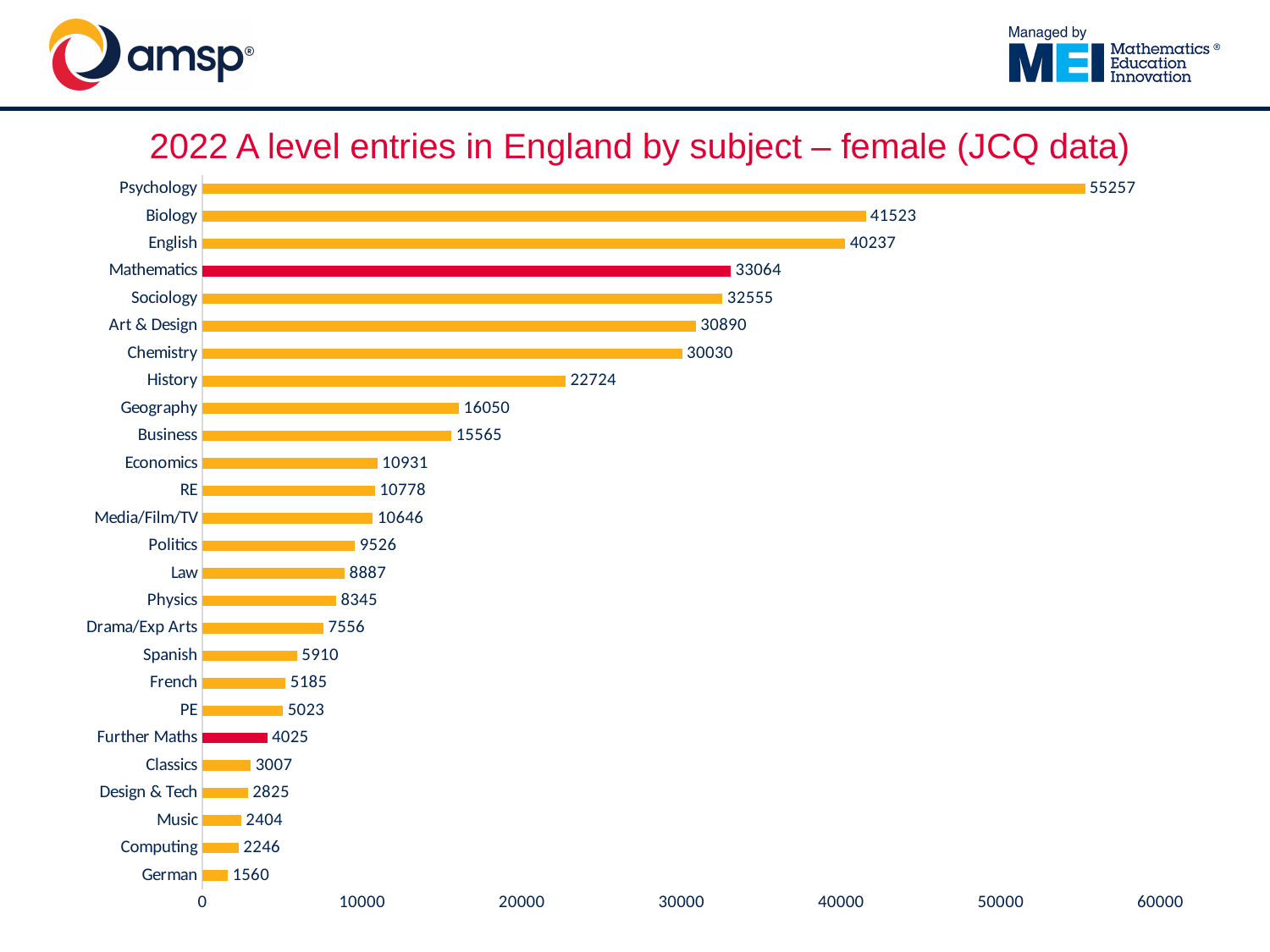
Which subject has the lowest number of female A level entries? German What is the number of female A level entries for Further Maths? 4025 What type of chart is shown on the slide? Bar chart Which subject has the highest number of female A level entries? Psychology Which two subjects are highlighted with red bars instead of orange? Mathematics and Further Maths What is the number of female A level entries for Chemistry? 30030 What is the difference between the female entries for Psychology and Biology? 13734 What is the difference between the female entries for Mathematics and Further Maths? 29039 What is the number of female A level entries for Mathematics? 33064 Which subject has more female entries, Chemistry or Physics? Chemistry Is the value for History greater or less than 20000? greater How many subjects are shown in the chart? 26